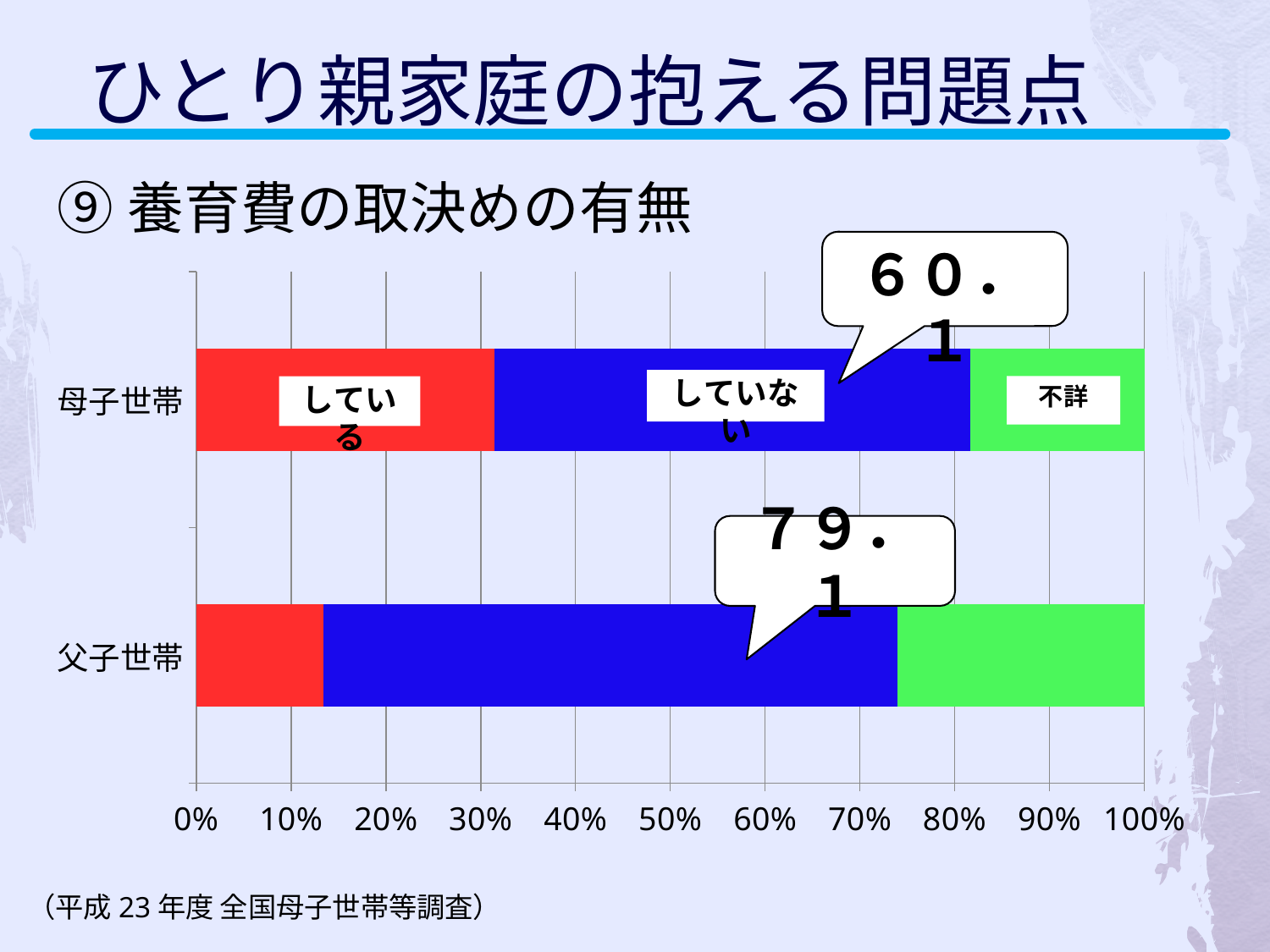
Is the している segment for 母子世帯 greater or less than 40%? less What value does the callout pointing to the していない segment of 母子世帯 show? 60.1 What is the title of the chart section on the slide? ⑨ 養育費の取決めの有無 What value does the callout pointing to the していない segment of 父子世帯 show? 79.1 Is the している segment for 父子世帯 greater or less than 20%? less What kind of chart is shown on the slide? bar chart Which household type has the larger 不詳 segment, 母子世帯 or 父子世帯? 父子世帯 How many series (segments) make up each stacked bar? 3 Does the していない segment for 父子世帯 end at a point greater or less than 70% on the axis? greater What colour is the 不詳 segment in the chart? green How many categories (household types) are plotted on the chart? 2 Which household type has the larger している segment, 母子世帯 or 父子世帯? 母子世帯